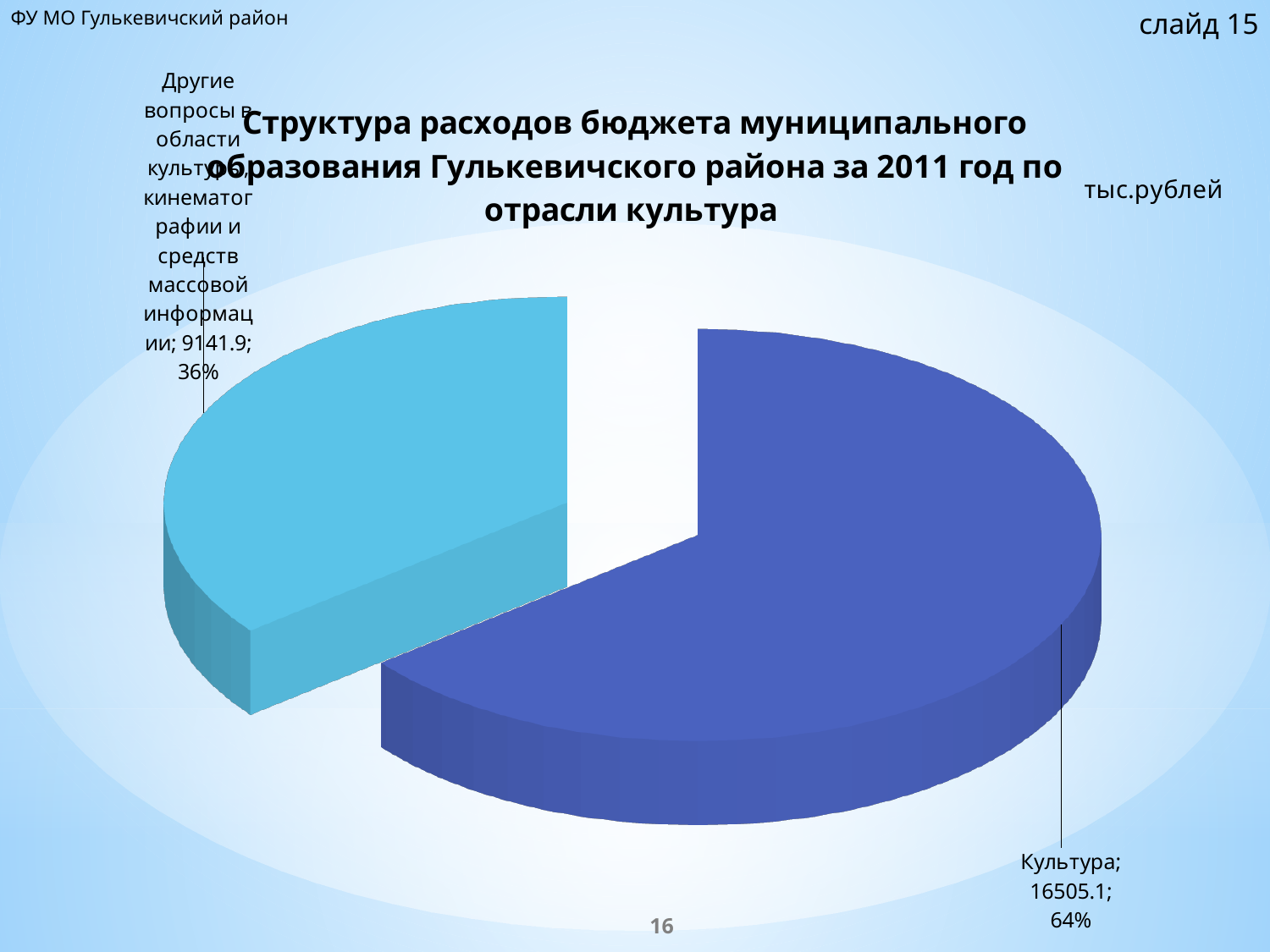
How many slices does the pie chart have? 2 What is the total of the two slices in the pie chart? 25647.0 What share of the pie does Другие вопросы в области культуры, кинематографии и средств массовой информации represent? 36% What kind of chart is shown on the slide? pie chart Which is larger: Культура or Другие вопросы в области культуры, кинематографии и средств массовой информации? Культура What is the value for Культура? 16505.1 What is the difference between the value for Культура and the value for Другие вопросы в области культуры, кинематографии и средств массовой информации? 7363.2 Which slice is the largest? Культура What share of the pie does Культура represent? 64% What is the value for Другие вопросы в области культуры, кинематографии и средств массовой информации? 9141.9 In what units are the values of the chart given, according to the slide? тыс.рублей Which slice is the smallest? Другие вопросы в области культуры, кинематографии и средств массовой информации